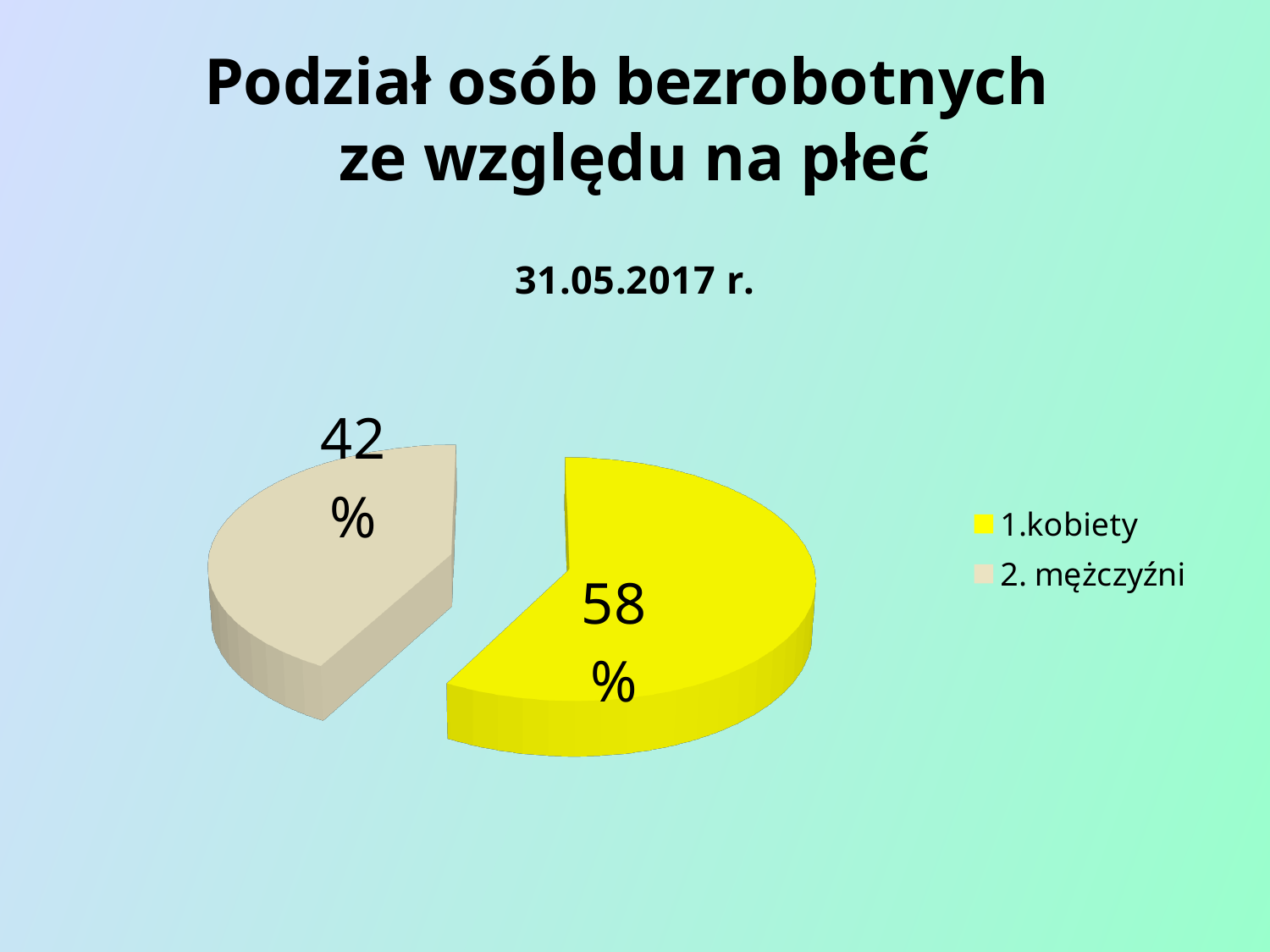
How many slices does the pie chart have? 2 How many entries does the legend list? 2 Which category has the largest slice of the pie? 1.kobiety What share of the pie does the '1.kobiety' slice represent? 58% What kind of chart is shown on the slide? Pie chart Which category has the smallest slice of the pie? 2. mężczyźni What colour is the '1.kobiety' slice? Yellow Which slice is larger, '1.kobiety' or '2. mężczyźni'? 1.kobiety What is the difference in percentage points between the '1.kobiety' and '2. mężczyźni' slices? 16 What share of the pie does the '2. mężczyźni' slice represent? 42% What is the title of the chart? 31.05.2017 r.